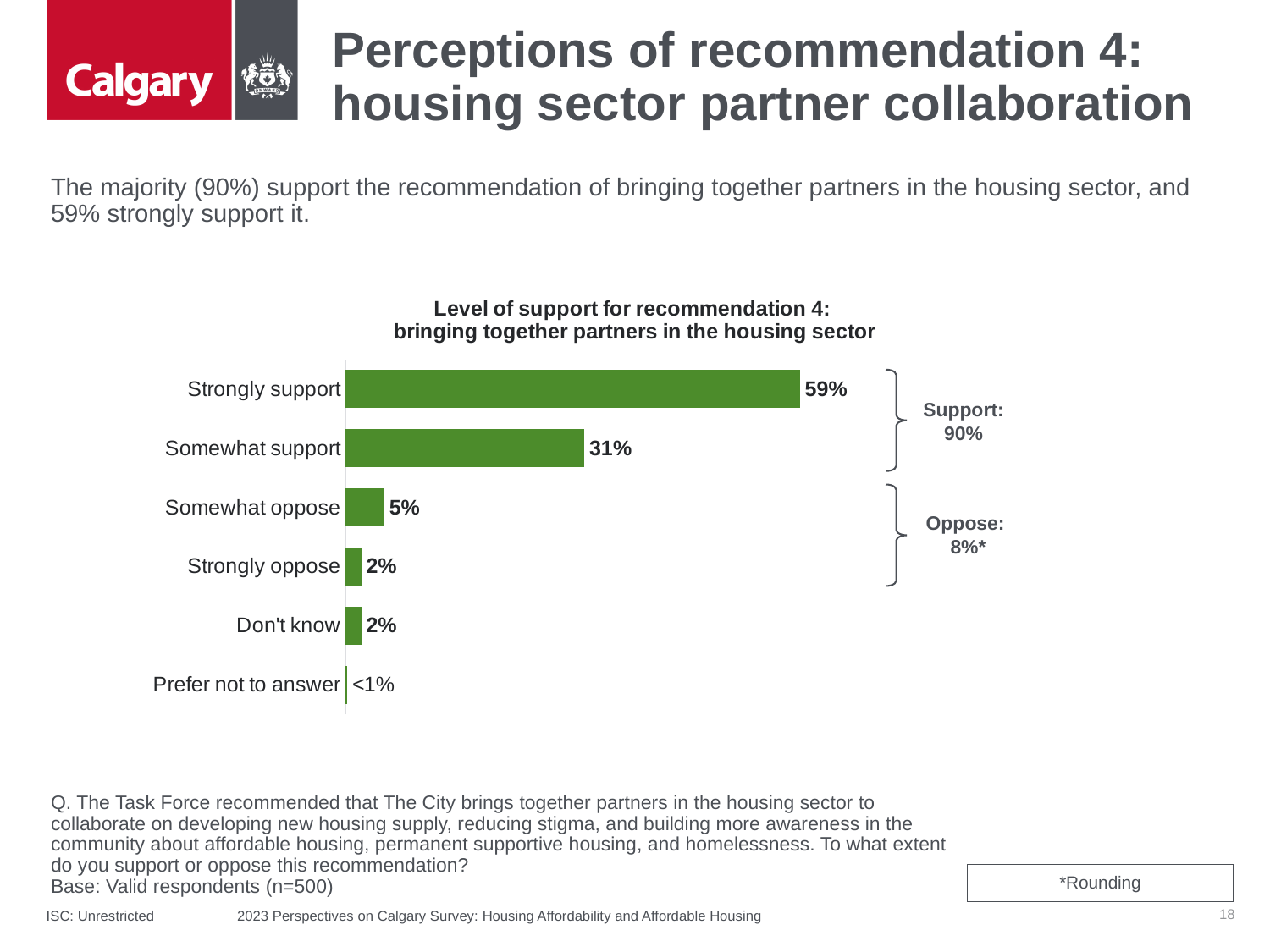
What is the value for Somewhat support? 31% What is the value for Somewhat oppose? 5% What percentage of respondents strongly support recommendation 4? 59% How many categories are shown in the chart? 6 What is the difference between Strongly support and Somewhat support? 28 percentage points What is the combined Support percentage shown beside the chart? 90% Which category has the highest value? Strongly support What is the value for Prefer not to answer? <1% What is the combined Oppose percentage shown beside the chart? 8% What kind of chart is this? Bar chart Which category has the lowest value? Prefer not to answer Which is larger, Somewhat oppose or Strongly oppose? Somewhat oppose